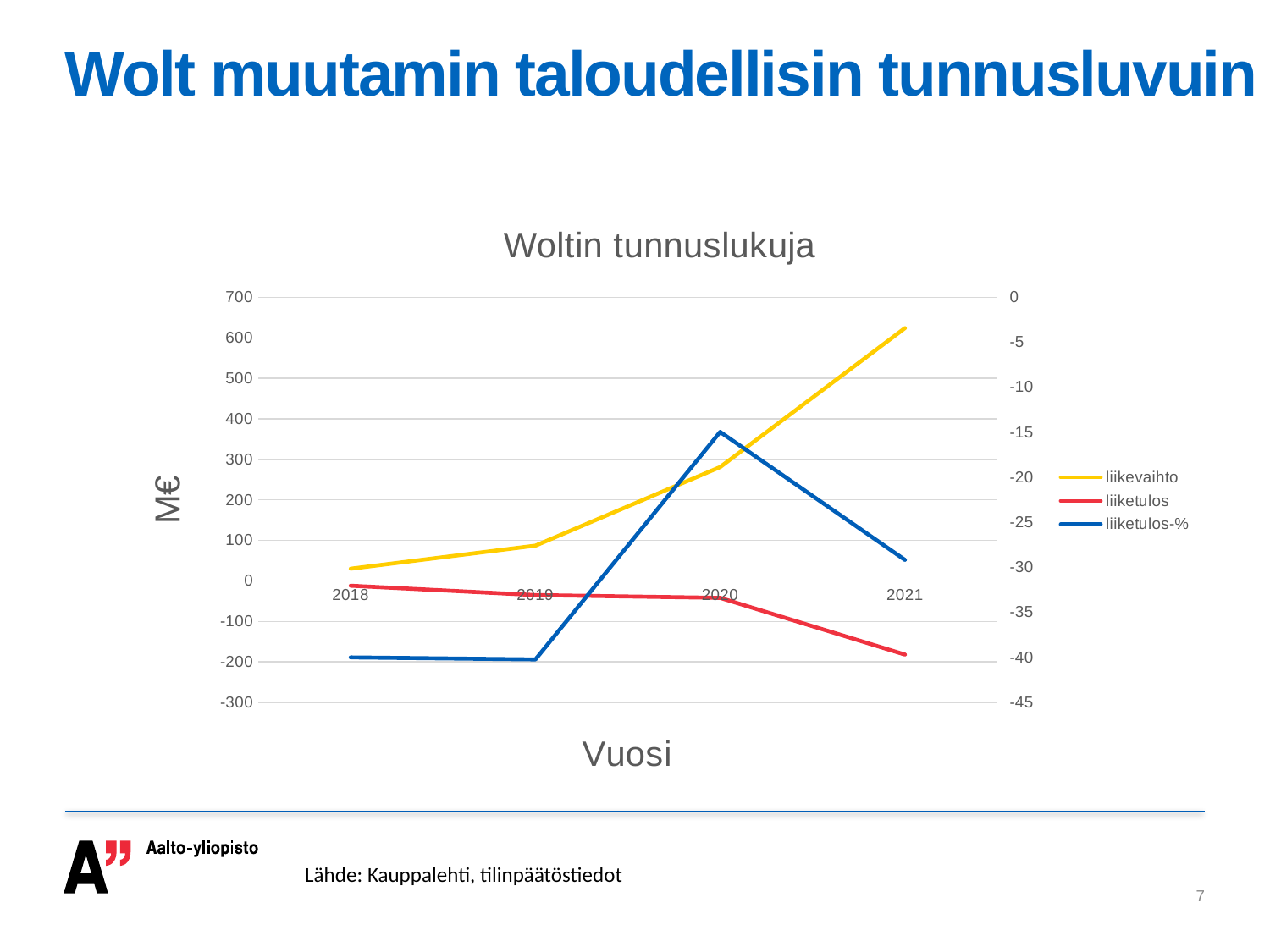
What kind of chart is shown on the slide? line chart Is the value for liiketulos in 2021 greater or less than -100? less Does the liikevaihto series rise or fall from 2018 to 2021? rise Does the liiketulos series rise or fall from 2018 to 2021? fall What is the label of the x axis? Vuosi Is the value for liikevaihto in 2021 greater or less than 500? greater In which year is liiketulos lowest? 2021 How many series does the legend list? 3 How many years are plotted along the x axis? 4 Which is larger, liikevaihto in 2018 or liikevaihto in 2020? 2020 In which year is liikevaihto highest? 2021 What is the title of the chart? Woltin tunnuslukuja